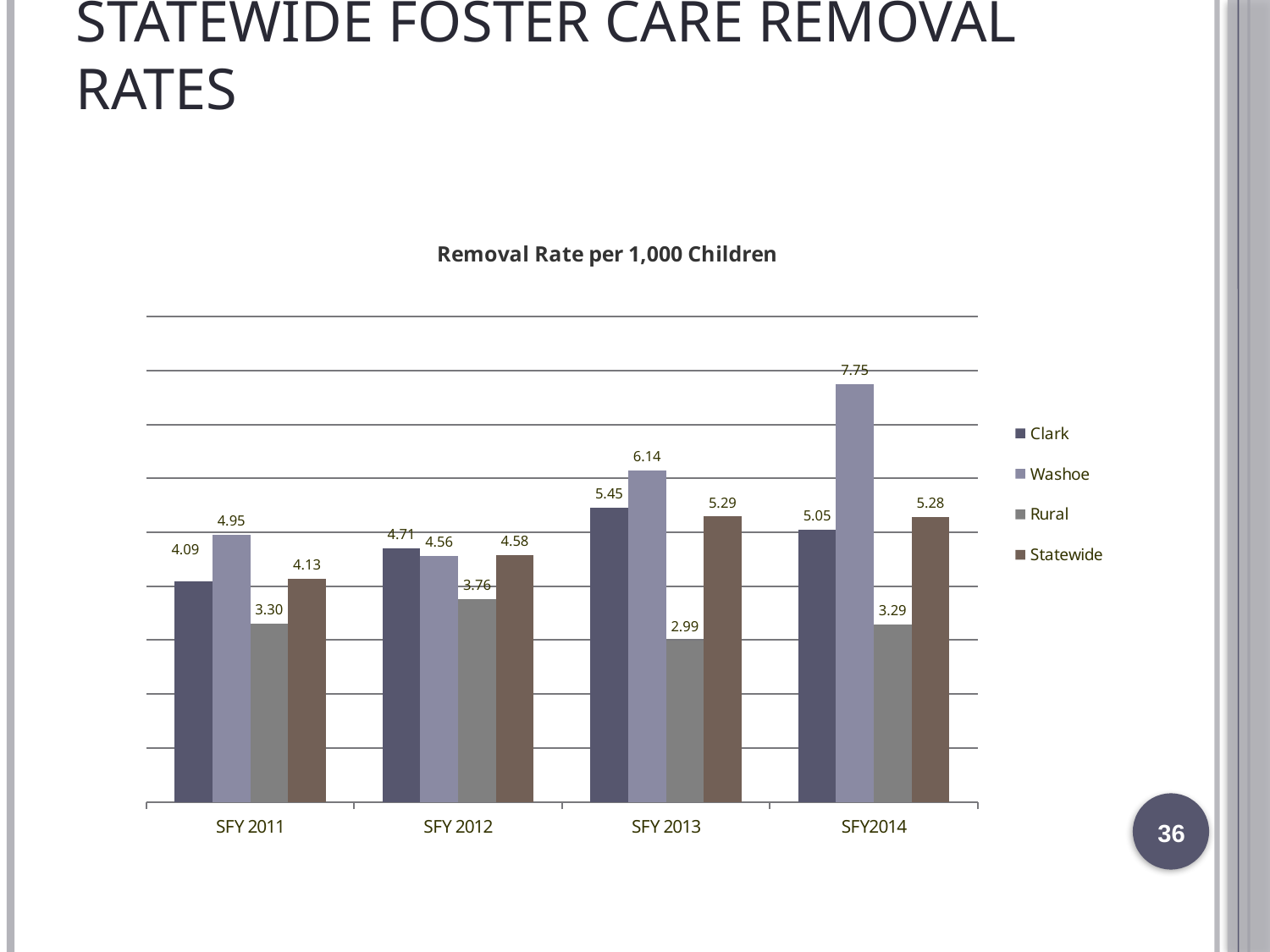
Which is larger in SFY 2012, the Clark rate or the Washoe rate? Clark What is the Washoe removal rate for SFY2014? 7.75 How many series does the legend list? 4 What kind of chart is shown on the slide? Bar chart In which year is the Washoe removal rate highest? SFY2014 Does the Statewide removal rate rise or fall from SFY 2011 to SFY 2013? Rise What is the Statewide removal rate for SFY 2011? 4.13 What is the difference between the Washoe and Rural removal rates in SFY2014? 4.46 What is the Clark removal rate for SFY 2012? 4.71 In which year is the Rural removal rate lowest? SFY 2013 How many fiscal years are shown on the x axis? 4 What is the Rural removal rate for SFY 2013? 2.99